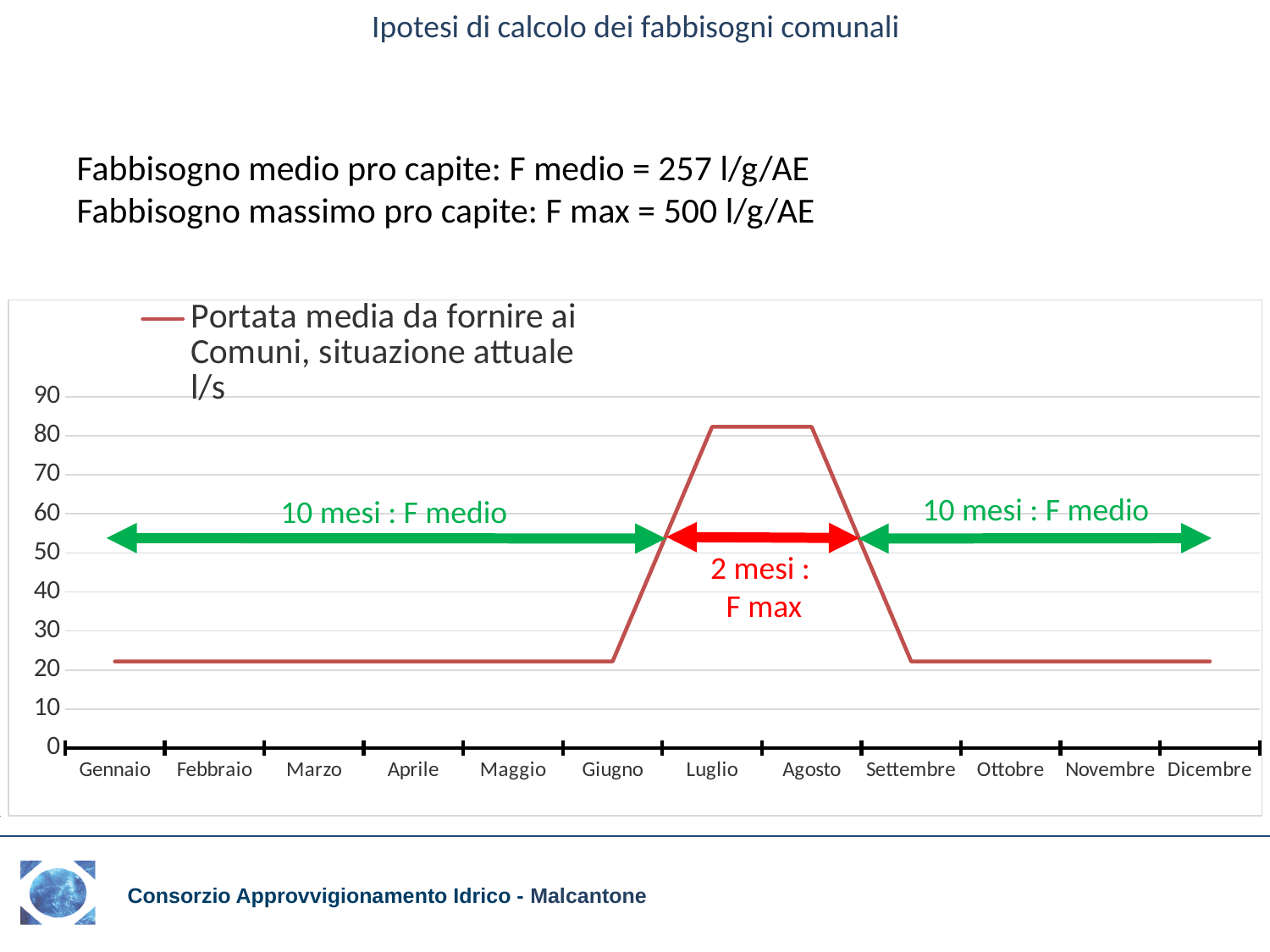
Is the value for Agosto greater or less than 60? greater Is the value for Gennaio greater or less than 30? less Does the line rise or fall between Agosto and Settembre? fall Is the value for Dicembre greater or less than 40? less How many series does the chart legend list? 1 Which has the larger value, Settembre or Agosto? Agosto Which has the larger value, Luglio or Gennaio? Luglio How many months are shown on the x axis of the chart? 12 What is the legend entry of the series plotted in the chart? Portata media da fornire ai Comuni, situazione attuale l/s Does the line rise or fall between Giugno and Luglio? rise What kind of chart is shown on the slide? line chart